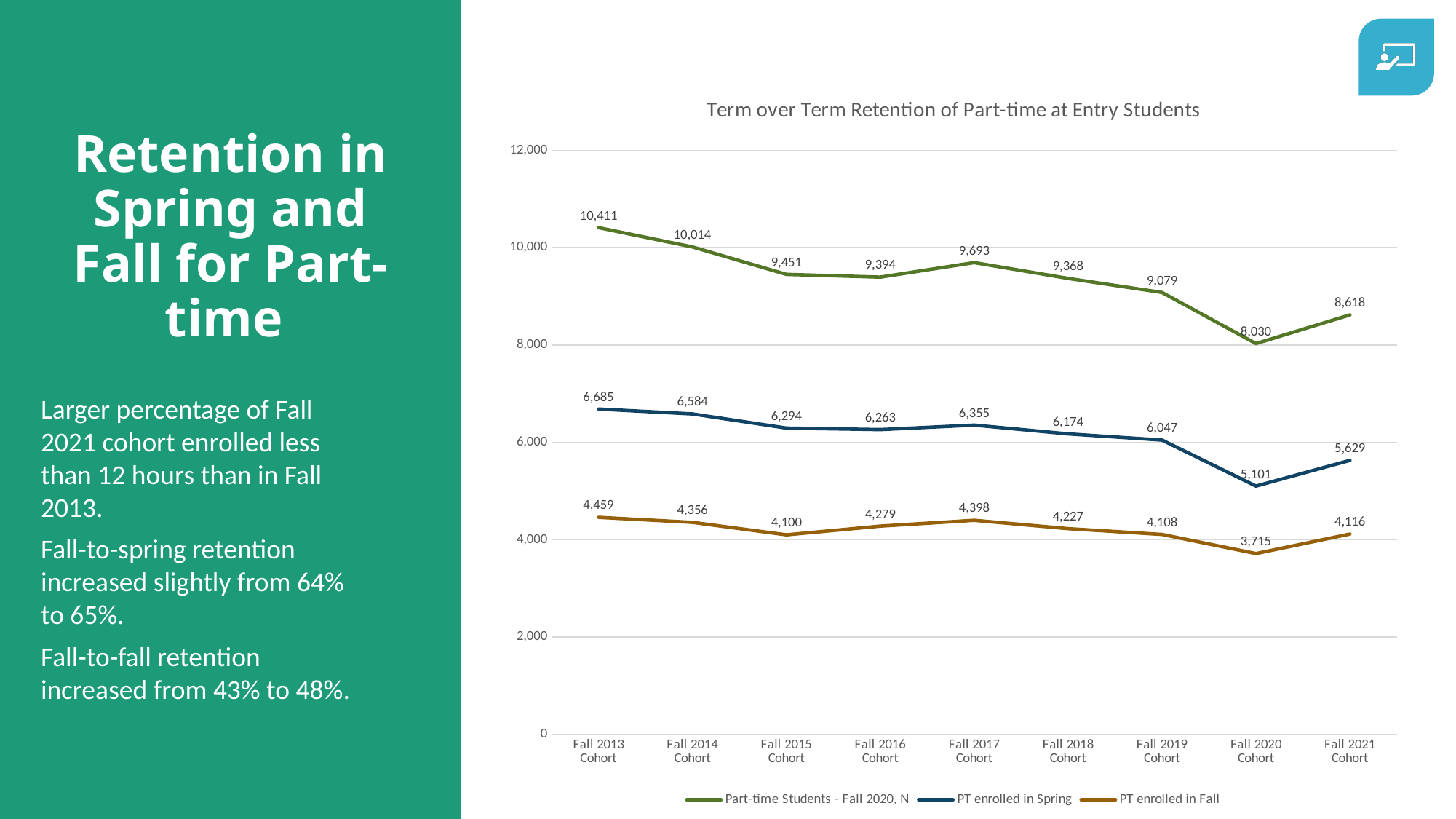
What is the title of the chart? Term over Term Retention of Part-time at Entry Students Which is larger: the PT enrolled in Fall value for the Fall 2017 Cohort or for the Fall 2016 Cohort? Fall 2017 Cohort Is the Part-time Students - Fall 2020, N value for the Fall 2021 Cohort greater or less than 10,000? less How many series does the legend list? 3 How many part-time students were enrolled in Spring for the Fall 2021 Cohort? 5,629 Which cohort has the highest value for the PT enrolled in Fall series? Fall 2013 Cohort What is the PT enrolled in Fall value for the Fall 2020 Cohort? 3,715 Which cohort has the lowest value for the PT enrolled in Spring series? Fall 2020 Cohort How many cohorts are shown on the x axis? 9 What is the difference between the PT enrolled in Spring values for the Fall 2013 Cohort and the Fall 2021 Cohort? 1,056 What kind of chart is shown on the slide? line chart What is the value of the Part-time Students - Fall 2020, N series for the Fall 2013 Cohort? 10,411